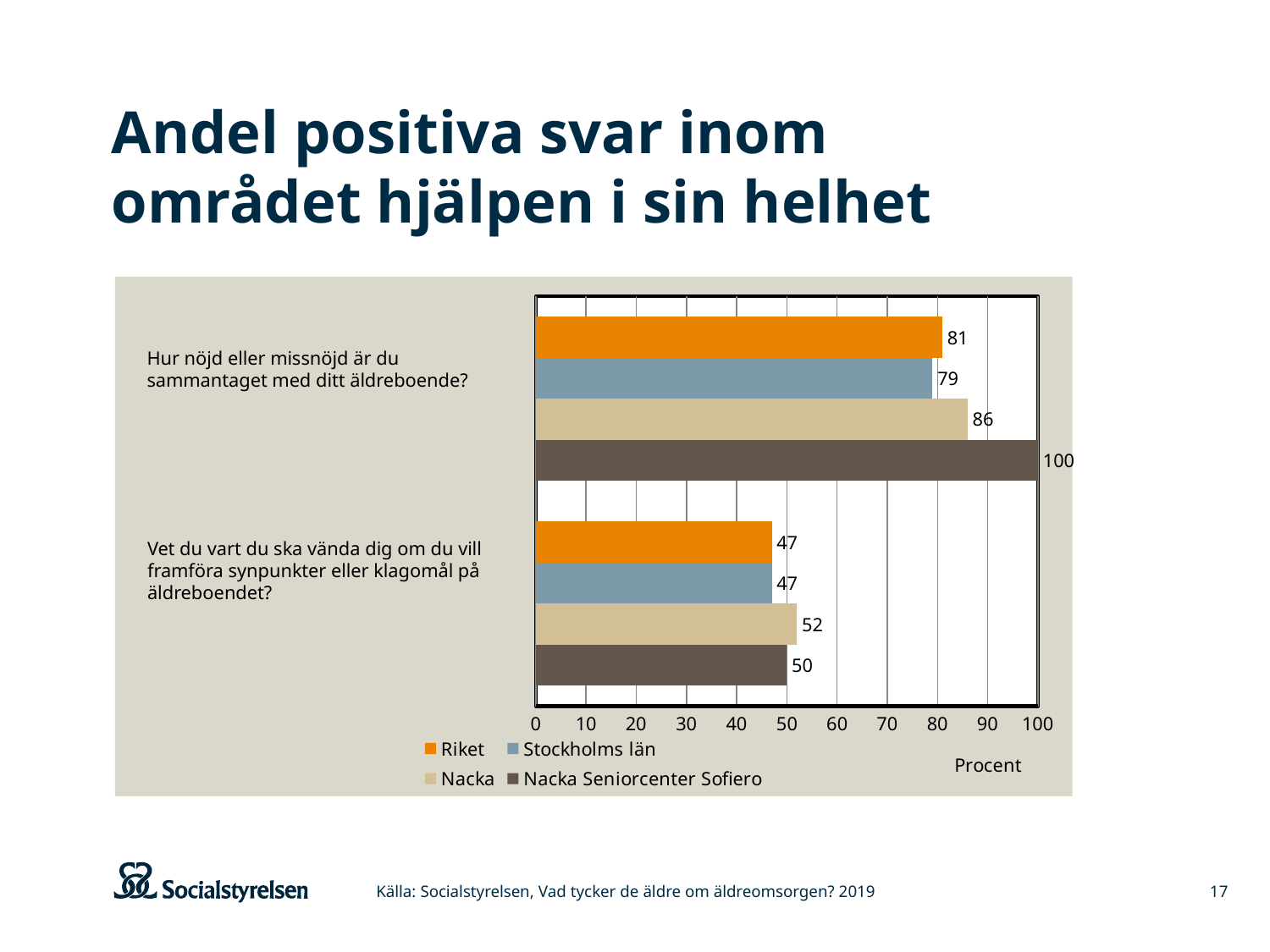
What is the label on the horizontal axis of the chart? Procent Which series has the lowest value for the question "Hur nöjd eller missnöjd är du sammantaget med ditt äldreboende?"? Stockholms län Is the value for Nacka for the question "Hur nöjd eller missnöjd är du sammantaget med ditt äldreboende?" greater or less than 80? greater Which series has the highest value for the question "Hur nöjd eller missnöjd är du sammantaget med ditt äldreboende?"? Nacka Seniorcenter Sofiero What is the value for Nacka Seniorcenter Sofiero for the question "Hur nöjd eller missnöjd är du sammantaget med ditt äldreboende?"? 100 What kind of chart is shown on the slide? Bar chart What is the value for Riket for the question "Vet du vart du ska vända dig om du vill framföra synpunkter eller klagomål på äldreboendet?"? 47 What is the value for Stockholms län for the question "Hur nöjd eller missnöjd är du sammantaget med ditt äldreboende?"? 79 What is the value for Nacka for the question "Vet du vart du ska vända dig om du vill framföra synpunkter eller klagomål på äldreboendet?"? 52 What is the difference between the Nacka Seniorcenter Sofiero value and the Riket value for the question "Hur nöjd eller missnöjd är du sammantaget med ditt äldreboende?"? 19 For the question "Vet du vart du ska vända dig om du vill framföra synpunkter eller klagomål på äldreboendet?", which is larger: the value for Nacka or the value for Nacka Seniorcenter Sofiero? Nacka How many series does the legend list? 4